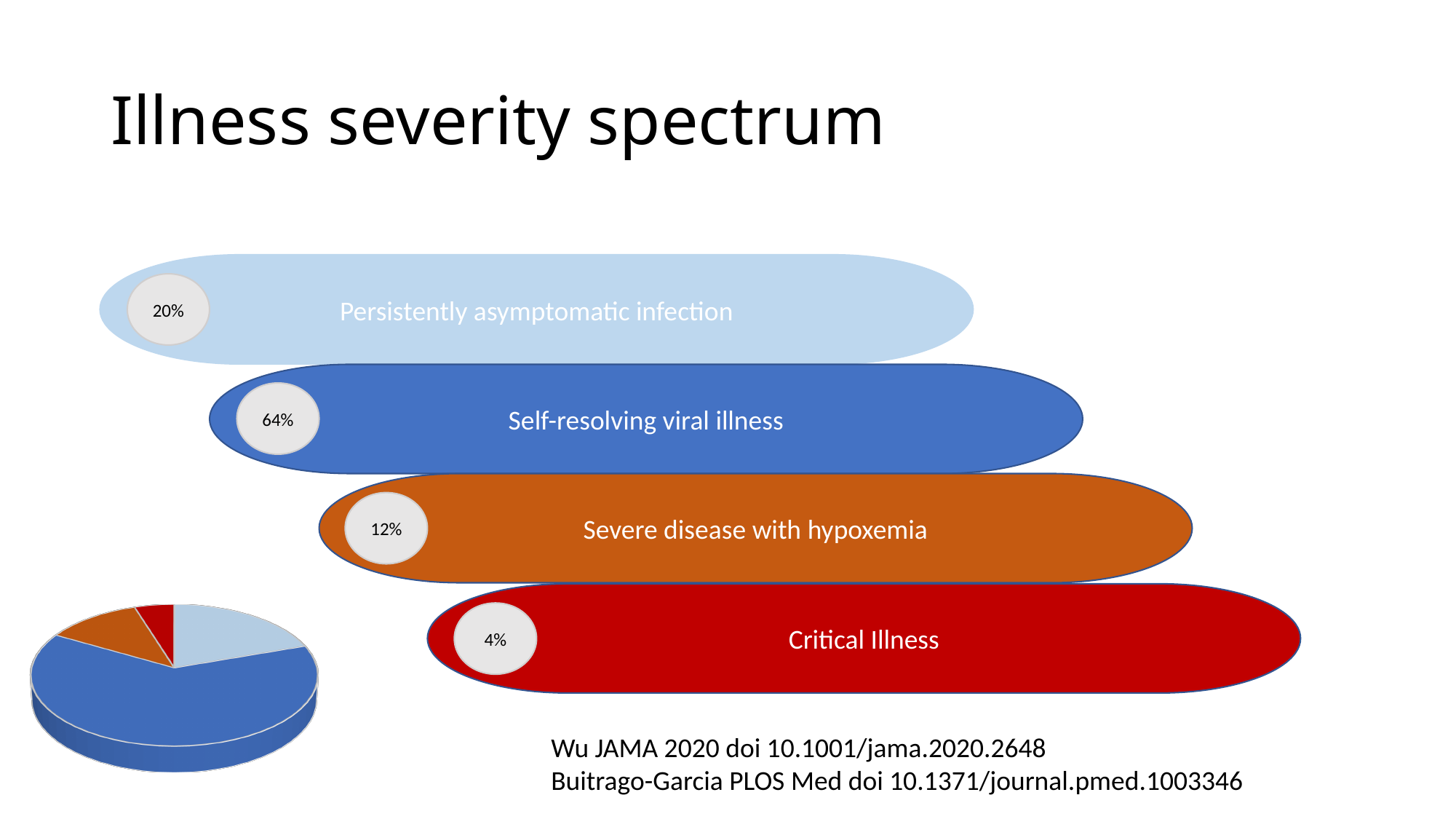
What percentage is shown for Persistently asymptomatic infection? 20% Which category has the smallest slice of the pie chart? Critical Illness What kind of chart is shown at the bottom left of the slide? pie chart What percentage is shown for Self-resolving viral illness? 64% How many slices does the pie chart have? 4 What percentage is shown for Severe disease with hypoxemia? 12% What is the combined percentage of Severe disease with hypoxemia and Critical Illness? 16% What is the difference between the percentages for Self-resolving viral illness and Persistently asymptomatic infection? 44% Which category has the largest slice of the pie chart? Self-resolving viral illness What colour is the slice of the pie chart representing Critical Illness? red Which is larger, the share for Severe disease with hypoxemia or for Critical Illness? Severe disease with hypoxemia What percentage is shown for Critical Illness? 4%